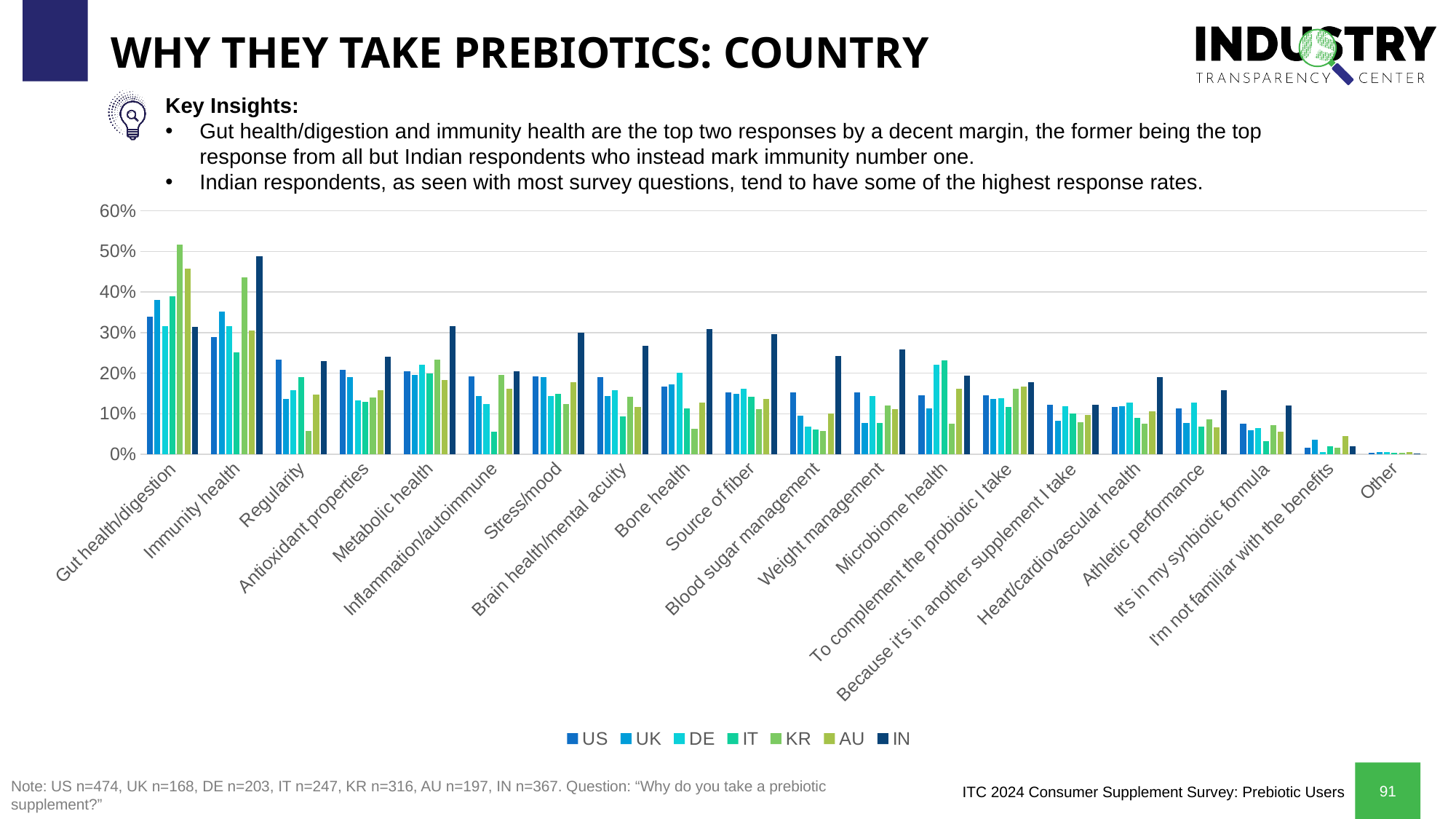
Is the AU value for Regularity greater or less than 10%? greater Which country has the highest value for Gut health/digestion? KR For Immunity health, which is larger: the KR value or the IT value? KR What is the title of the chart slide? WHY THEY TAKE PREBIOTICS: COUNTRY How many series does the legend list? 7 Which category has the highest value for the US series? Gut health/digestion Is the KR value for Gut health/digestion greater or less than 50%? greater Is the IN value for Immunity health greater or less than 50%? less How many response categories are shown along the x axis? 20 What kind of chart is shown on the slide? Bar chart Which category has the highest value for the IN series? Immunity health